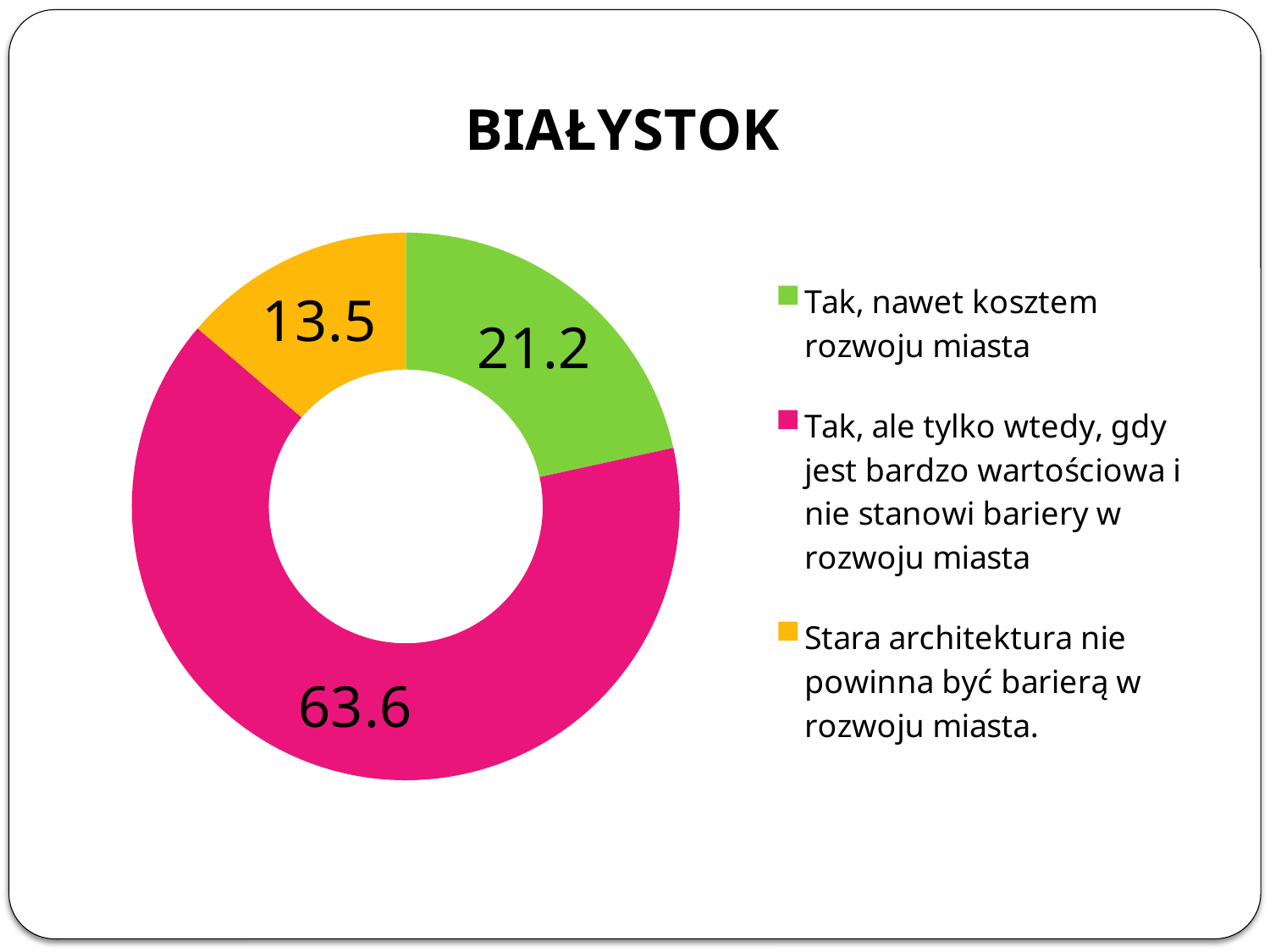
What kind of chart is shown on the slide? Doughnut chart What is the value for "Stara architektura nie powinna być barierą w rozwoju miasta."? 13.5 What is the value for "Tak, ale tylko wtedy, gdy jest bardzo wartościowa i nie stanowi bariery w rozwoju miasta"? 63.6 Which is larger: the value for "Tak, nawet kosztem rozwoju miasta" or for "Stara architektura nie powinna być barierą w rozwoju miasta."? Tak, nawet kosztem rozwoju miasta Which category has the smallest value? Stara architektura nie powinna być barierą w rozwoju miasta. What is the difference between the largest and smallest values on the chart? 50.1 What is the difference between the values for "Tak, nawet kosztem rozwoju miasta" and "Stara architektura nie powinna być barierą w rozwoju miasta."? 7.7 What colour is the slice for "Stara architektura nie powinna być barierą w rozwoju miasta."? Orange Which category has the largest value? Tak, ale tylko wtedy, gdy jest bardzo wartościowa i nie stanowi bariery w rozwoju miasta How many categories does the chart show? 3 What is the title of the chart? BIAŁYSTOK What is the value for "Tak, nawet kosztem rozwoju miasta"? 21.2